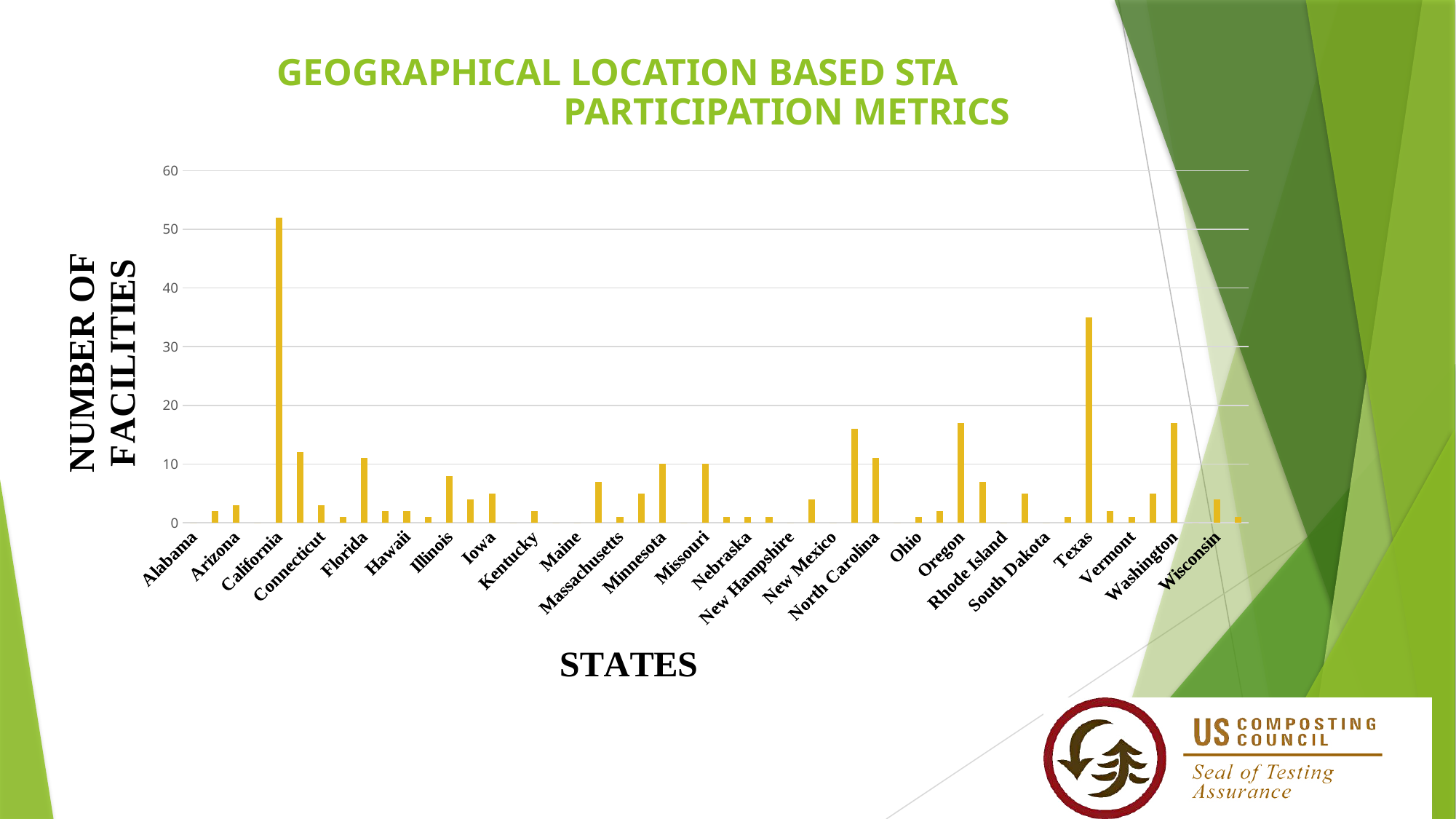
Is the value for Texas greater or less than 30? greater Is the value for Texas greater or less than 40? less What is the title of the vertical axis? NUMBER OF FACILITIES Which state has the highest number of facilities? California What kind of chart is shown on the slide? bar chart What is the title of the horizontal axis? STATES Which has more facilities, North Carolina or Ohio? North Carolina Is the value for Alabama greater or less than 10? less Which has more facilities, California or Texas? California